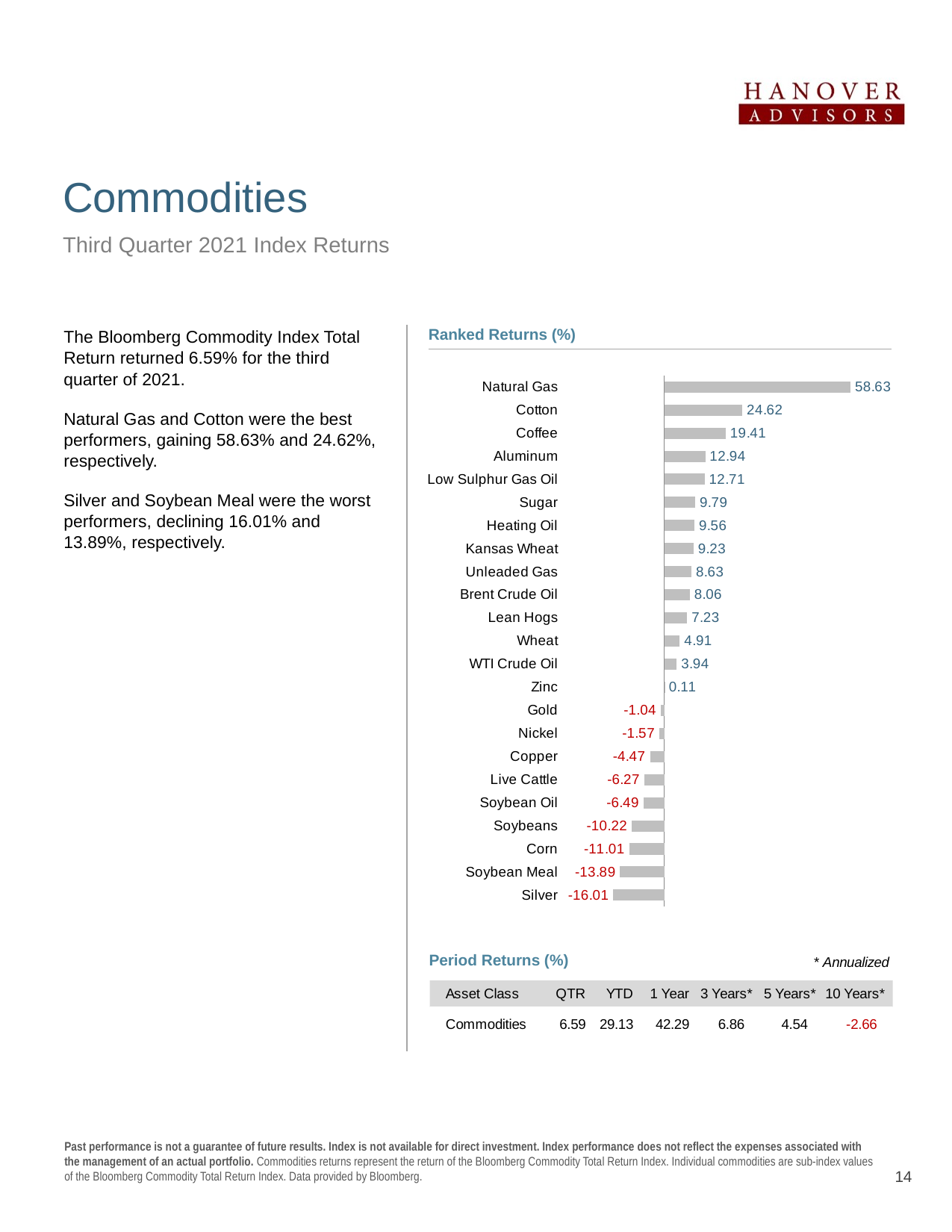
In the Ranked Returns (%) chart, which is larger, the value for Sugar or the value for Wheat? Sugar In the Ranked Returns (%) chart, what is the value for Natural Gas? 58.63 In the Ranked Returns (%) chart, what is the value for Zinc? 0.11 In the Ranked Returns (%) chart, what is the difference between the values for Natural Gas and Cotton? 34.01 In the Ranked Returns (%) chart, what is the value for Soybean Meal? -13.89 In the Ranked Returns (%) chart, what is the difference between the values for Aluminum and Low Sulphur Gas Oil? 0.23 What is the title of the chart on the slide? Ranked Returns (%) In the Ranked Returns (%) chart, which commodity has the highest return? Natural Gas What kind of chart is the Ranked Returns (%) chart? Bar chart In the Ranked Returns (%) chart, which commodity has the lowest return? Silver How many commodities are shown in the Ranked Returns (%) chart? 23 In the Ranked Returns (%) chart, what is the value for Coffee? 19.41